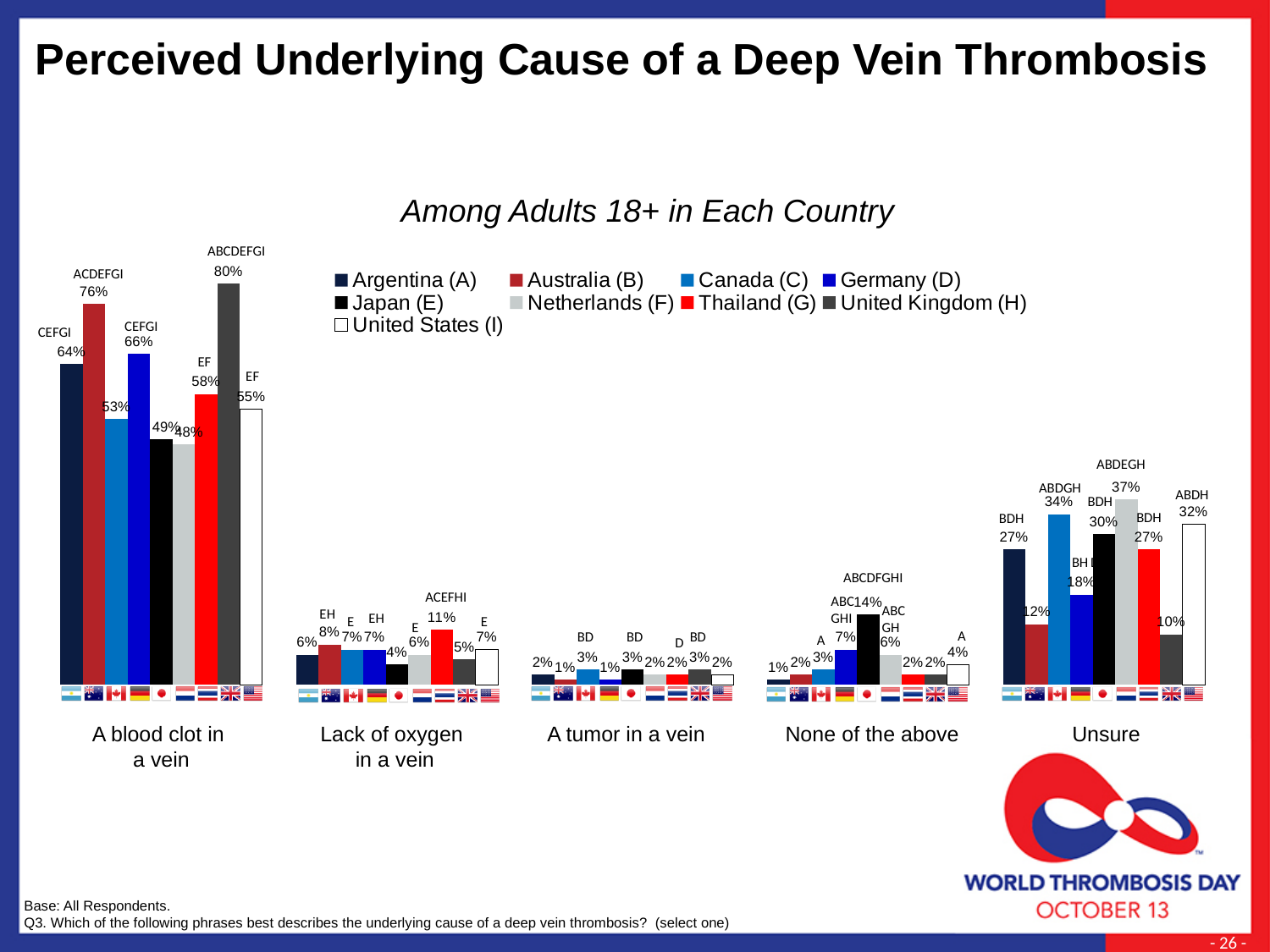
What percentage of adults in the Netherlands answered 'Unsure'? 37% How many countries does the legend list? 9 What is the difference between Australia's and Canada's values for 'A blood clot in a vein'? 23 percentage points Which country has the lowest value for 'A blood clot in a vein'? Netherlands (F) How many response categories are shown along the x axis? 5 What type of chart is shown on the slide? Bar chart Which country has the lowest value for 'Unsure'? United Kingdom (H) Which country has the highest value for 'A blood clot in a vein'? United Kingdom (H) What percentage of adults in Japan chose 'None of the above'? 14% What percentage of adults in the United Kingdom said a deep vein thrombosis is caused by a blood clot in a vein? 80% For 'Unsure', which is larger: the value for Canada or the value for Germany? Canada What percentage of adults in Thailand chose 'Lack of oxygen in a vein'? 11%